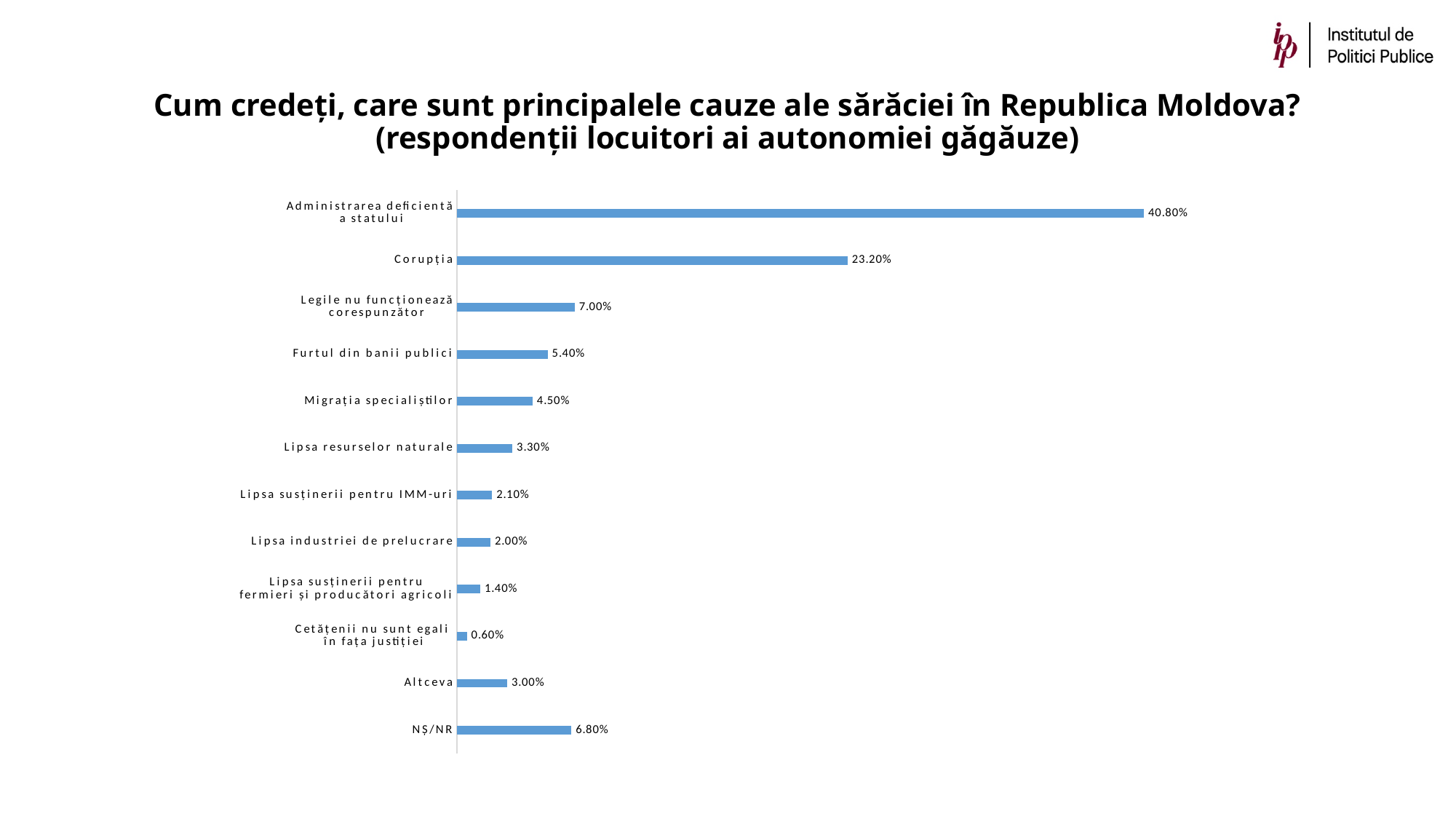
What is the value for Migrația specialiștilor? 4.50% What colour are the bars in the chart? Blue What kind of chart is shown on the slide? Bar chart How many categories are shown in the chart? 12 Which category has the lowest value? Cetățenii nu sunt egali în fața justiției Which is larger: the value for Furtul din banii publici or the value for Legile nu funcționează corespunzător? Legile nu funcționează corespunzător What is the value for NȘ/NR? 6.80% What is the difference between the values for Administrarea deficientă a statului and Corupția? 17.60% What is the value for Lipsa susținerii pentru fermieri și producători agricoli? 1.40% What is the difference between the values for Altceva and Lipsa resurselor naturale? 0.30% What is the value for Corupția? 23.20% Which category has the highest value? Administrarea deficientă a statului